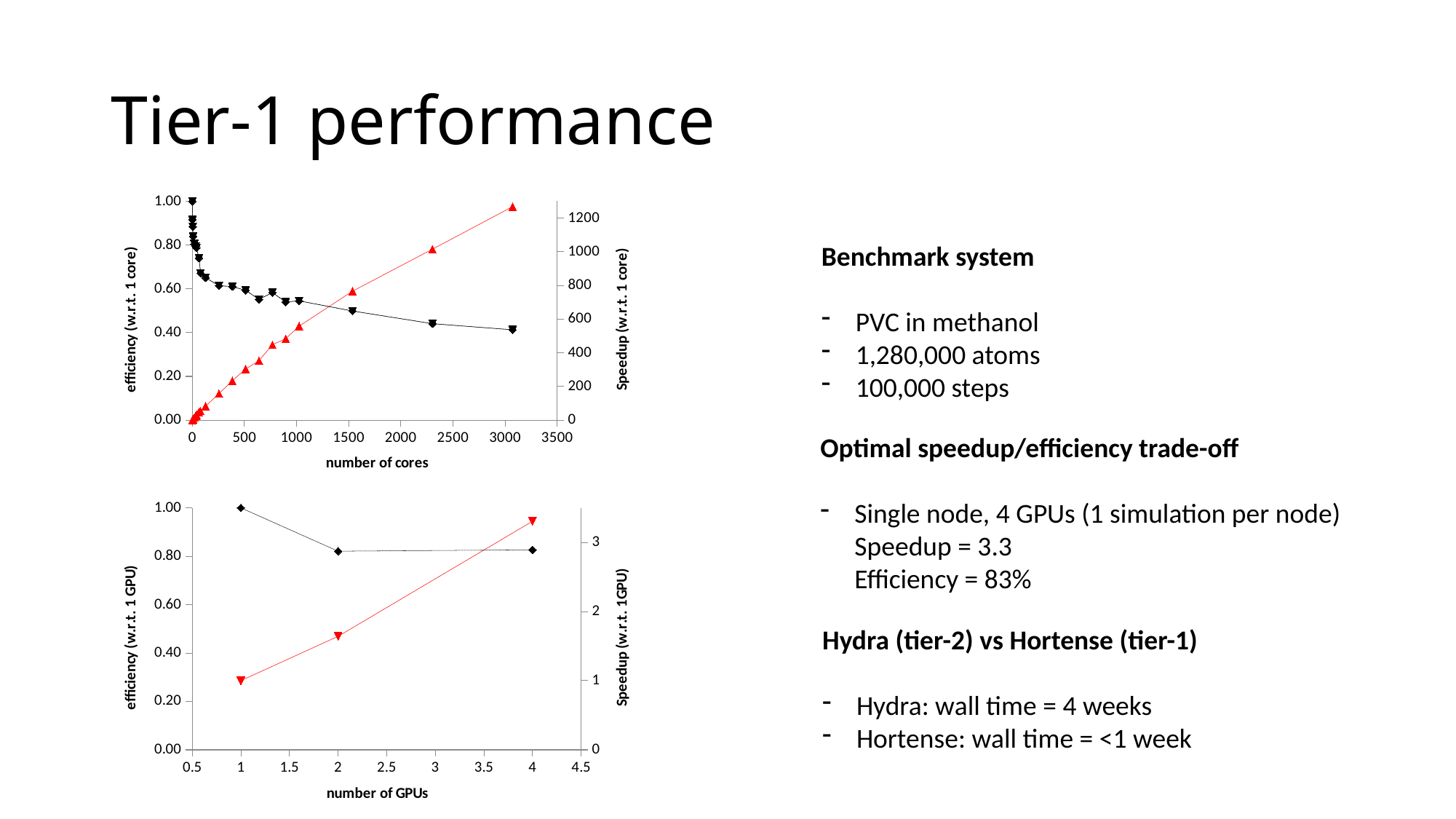
In the top chart (number of cores), is the speedup at about 3000 cores greater or less than 1000? greater In the bottom chart (number of GPUs), is the efficiency at 4 GPUs greater or less than 0.60? greater In the bottom chart (number of GPUs), how many data points does the speedup series have? 3 In the bottom chart (number of GPUs), what is the efficiency value at 1 GPU? 1.00 In the bottom chart (number of GPUs), is the speedup at 4 GPUs greater or less than 3? greater In the top chart (number of cores), does the efficiency rise or fall as the number of cores increases? fall In the bottom chart (number of GPUs), is the speedup larger at 2 GPUs or at 4 GPUs? 4 GPUs In the bottom chart (number of GPUs), at which number of GPUs is efficiency highest? 1 What kind of chart is the top chart (number of cores)? line chart In the bottom chart (number of GPUs), what is the speedup value at 1 GPU? 1 What is the x-axis title of the top chart? number of cores